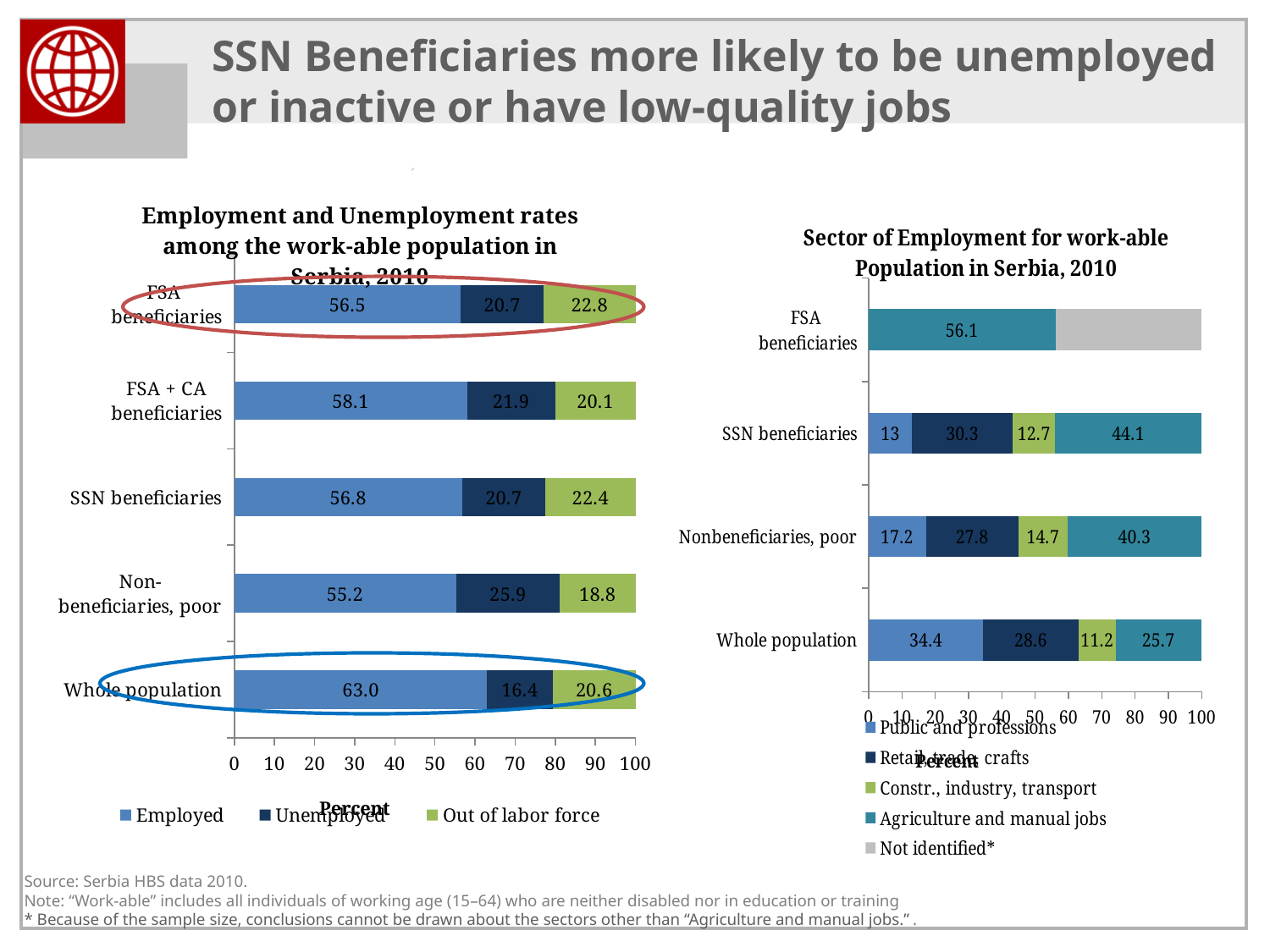
How many series does the legend of the left chart (Employment and Unemployment rates) list? 3 In the left chart (Employment and Unemployment rates), what is the Employed value for Whole population? 63.0 How many categories are shown in the left chart (Employment and Unemployment rates)? 5 In the left chart (Employment and Unemployment rates), which category has the highest Employed value? Whole population In the right chart (Sector of Employment), what is the Public and professions value for Whole population? 34.4 In the left chart (Employment and Unemployment rates), what is the Unemployed value for Non-beneficiaries, poor? 25.9 In the right chart (Sector of Employment), is the Constr., industry, transport value larger for Nonbeneficiaries, poor or for Whole population? Nonbeneficiaries, poor In the left chart (Employment and Unemployment rates), which category has the highest Unemployed value? Non-beneficiaries, poor In the right chart (Sector of Employment), what is the Agriculture and manual jobs value for SSN beneficiaries? 44.1 In the right chart (Sector of Employment), which category has the highest Agriculture and manual jobs value? FSA beneficiaries How many series does the legend of the right chart (Sector of Employment) list? 5 In the left chart (Employment and Unemployment rates), what is the difference between the Employed values for Whole population and FSA beneficiaries? 6.5